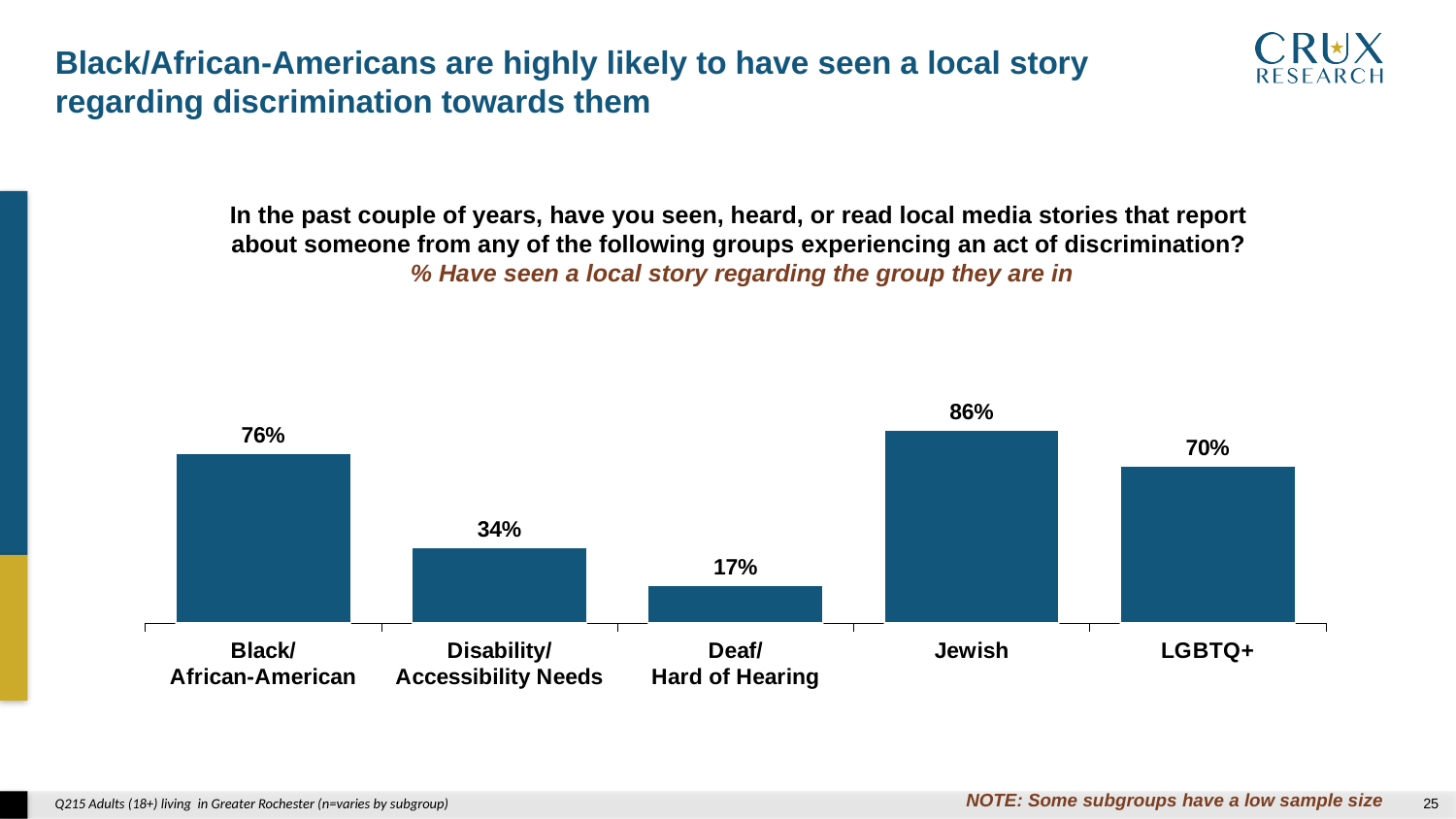
What is the italic subtitle above the chart? % Have seen a local story regarding the group they are in Which is larger, the value for LGBTQ+ or the value for Disability/Accessibility Needs? LGBTQ+ Which group has the lowest percentage? Deaf/Hard of Hearing What is the difference between the Disability/Accessibility Needs and Deaf/Hard of Hearing values? 17 percentage points How many groups are shown in the chart? 5 What is the difference between the Jewish and Black/African-American values? 10 percentage points Which group has the highest percentage? Jewish What kind of chart is shown on the slide? Bar chart What percentage of Black/African-American respondents have seen a local story regarding their group? 76% What is the value shown for Deaf/Hard of Hearing? 17% What is the value shown for the Jewish group? 86% What is the value shown for LGBTQ+? 70%